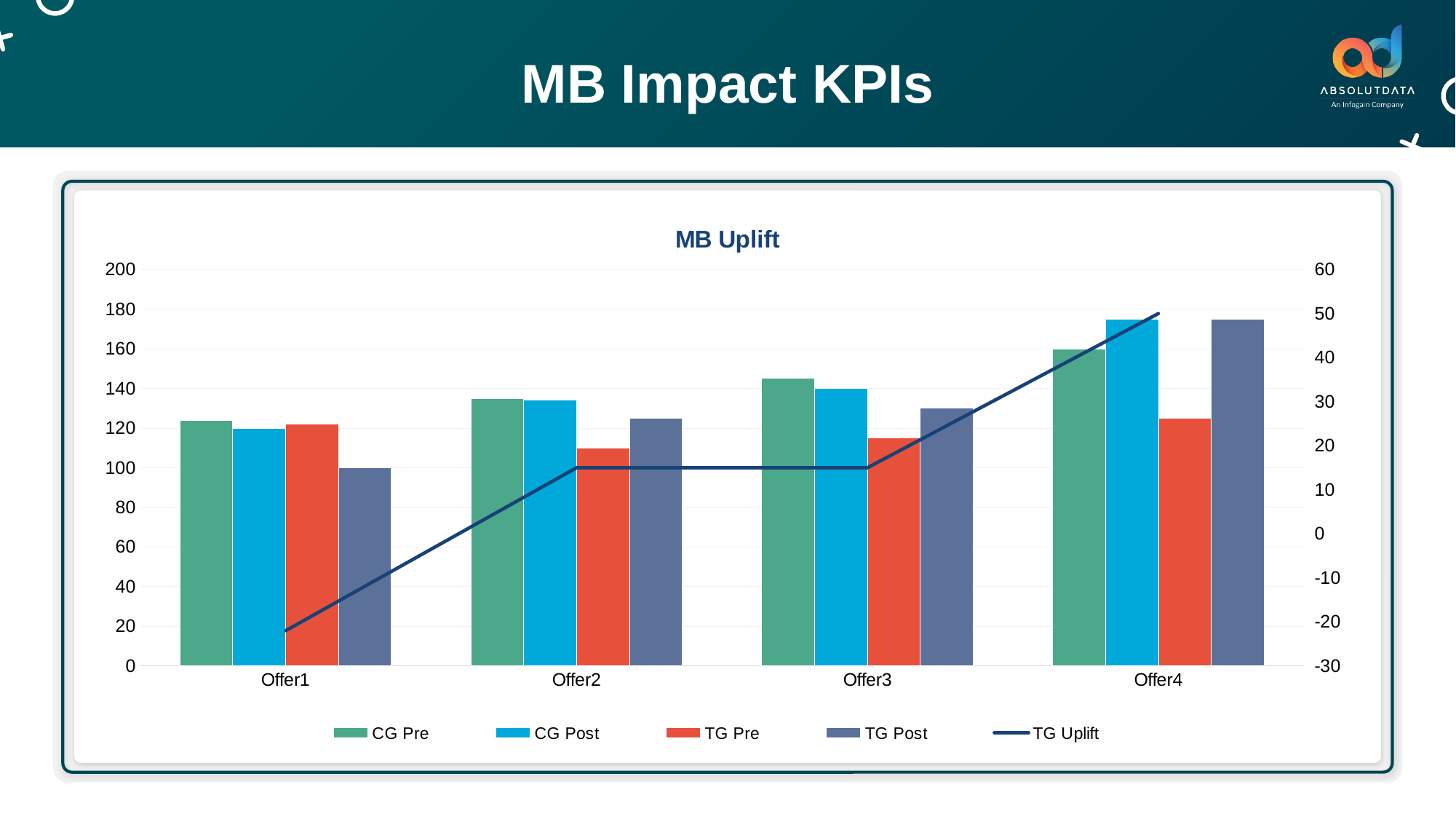
What is the value of TG Post for Offer1? 100 What is the value of CG Post for Offer1? 120 For Offer1, which is larger: CG Pre or TG Post? CG Pre How many series does the legend list? 5 Which offer has the highest TG Post value? Offer4 What is the value of CG Post for Offer3? 140 Which offer has the lowest TG Post value? Offer1 What is the value of CG Pre for Offer4? 160 Does the TG Uplift line rise or fall from Offer1 to Offer4? rise What is the difference between CG Post and TG Post for Offer1? 20 Is the TG Post value for Offer4 greater or less than 160? greater How many offers are shown on the x axis? 4